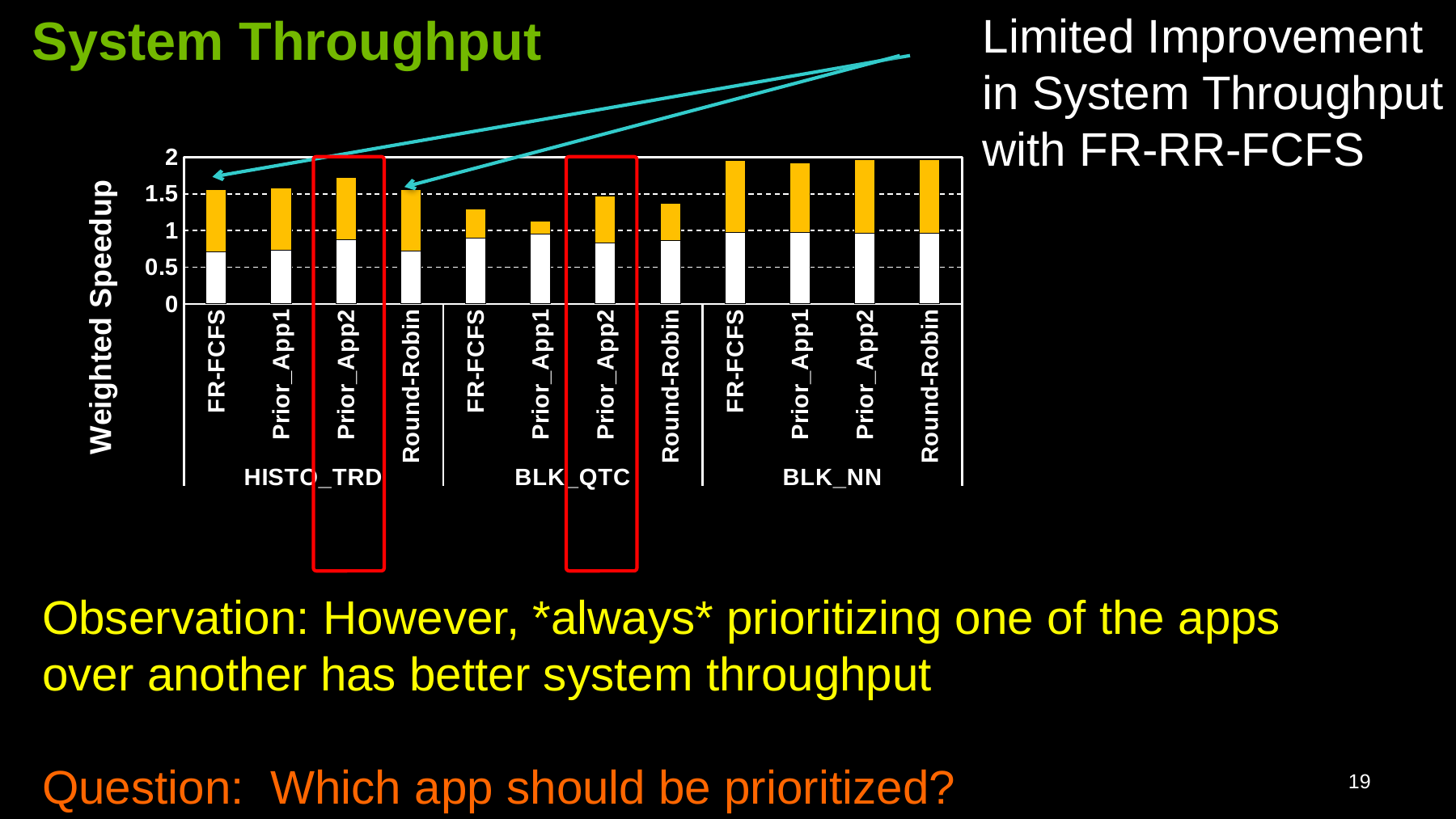
Which is larger: the total weighted speedup for Prior_App2 in HISTO_TRD or for Prior_App2 in BLK_QTC? Prior_App2 in HISTO_TRD What is the label of the y-axis of the chart? Weighted Speedup Is the total weighted speedup for Round-Robin in the BLK_NN group greater or less than 1.5? greater Is the total weighted speedup for Prior_App2 in the HISTO_TRD group greater or less than 1.5? greater Which scheduling policy has the lowest total weighted speedup in the BLK_QTC group? Prior_App1 What kind of chart is shown on the slide? Stacked bar chart Which scheduling policy has the highest total weighted speedup in the BLK_QTC group? Prior_App2 Is the total weighted speedup for FR-FCFS in the BLK_QTC group greater or less than 1.5? less Which scheduling policy has the highest total weighted speedup in the HISTO_TRD group? Prior_App2 How many application groups are shown along the x-axis of the chart? 3 What is the title of the chart on the slide? System Throughput How many bars are plotted in the chart in total? 12